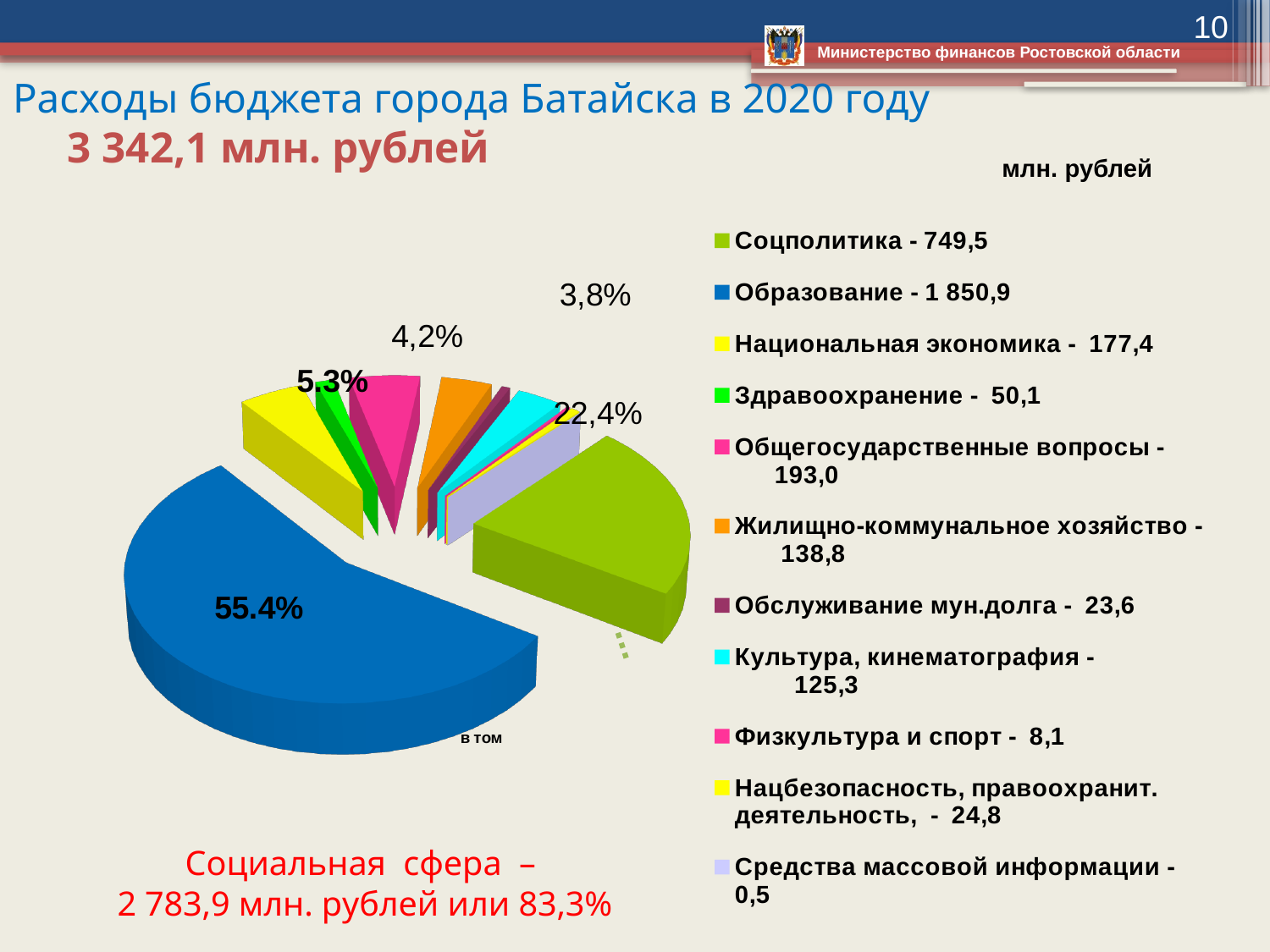
What share of the pie does the Образование slice (blue) represent? 55.4% How many categories does the legend of the pie chart list? 11 What is the value for Образование in the legend? 1 850,9 What is the value for Соцполитика in the legend? 749,5 Which is larger: Национальная экономика or Общегосударственные вопросы? Общегосударственные вопросы What kind of chart is shown on the slide? pie chart What total budget expenditure is stated in the slide title? 3 342,1 млн. рублей What is the value for Жилищно-коммунальное хозяйство? 138,8 Which category has the largest value? Образование What is the value for Обслуживание мун.долга? 23,6 What is the difference between the values for Образование and Соцполитика? 1 101,4 Which category has the smallest value? Средства массовой информации